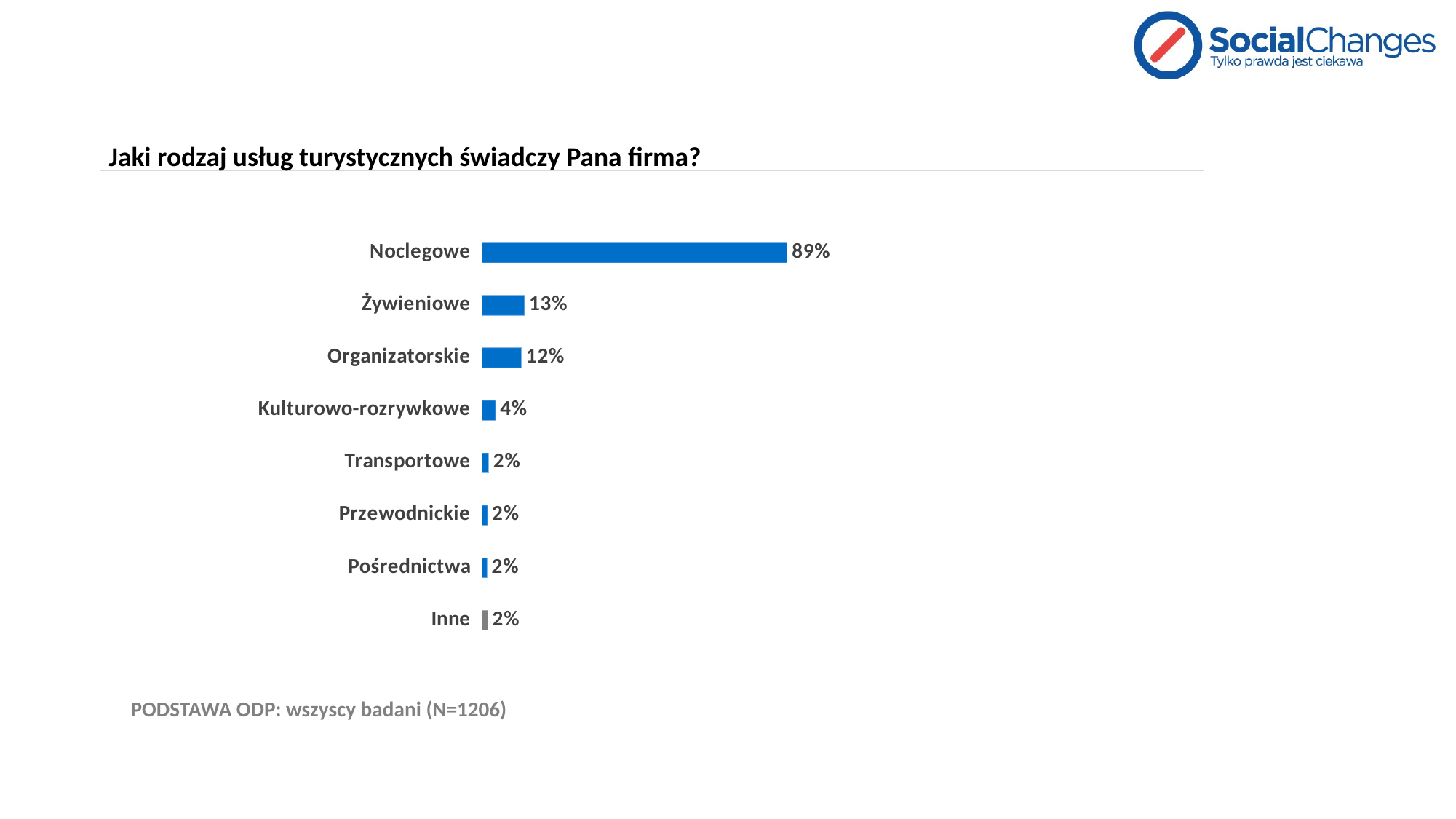
Which is larger, the value for Organizatorskie or the value for Kulturowo-rozrywkowe? Organizatorskie What is the value for Organizatorskie? 12% What is the value for Kulturowo-rozrywkowe? 4% What is the value for Noclegowe? 89% What is the value for Żywieniowe? 13% What kind of chart is shown on the slide? Bar chart How many categories are shown in the chart? 8 What is the value for Inne? 2% What is the title of the chart? Jaki rodzaj usług turystycznych świadczy Pana firma? What is the difference between the values for Noclegowe and Żywieniowe? 76% What is the difference between the values for Żywieniowe and Organizatorskie? 1% Which category has the highest value? Noclegowe